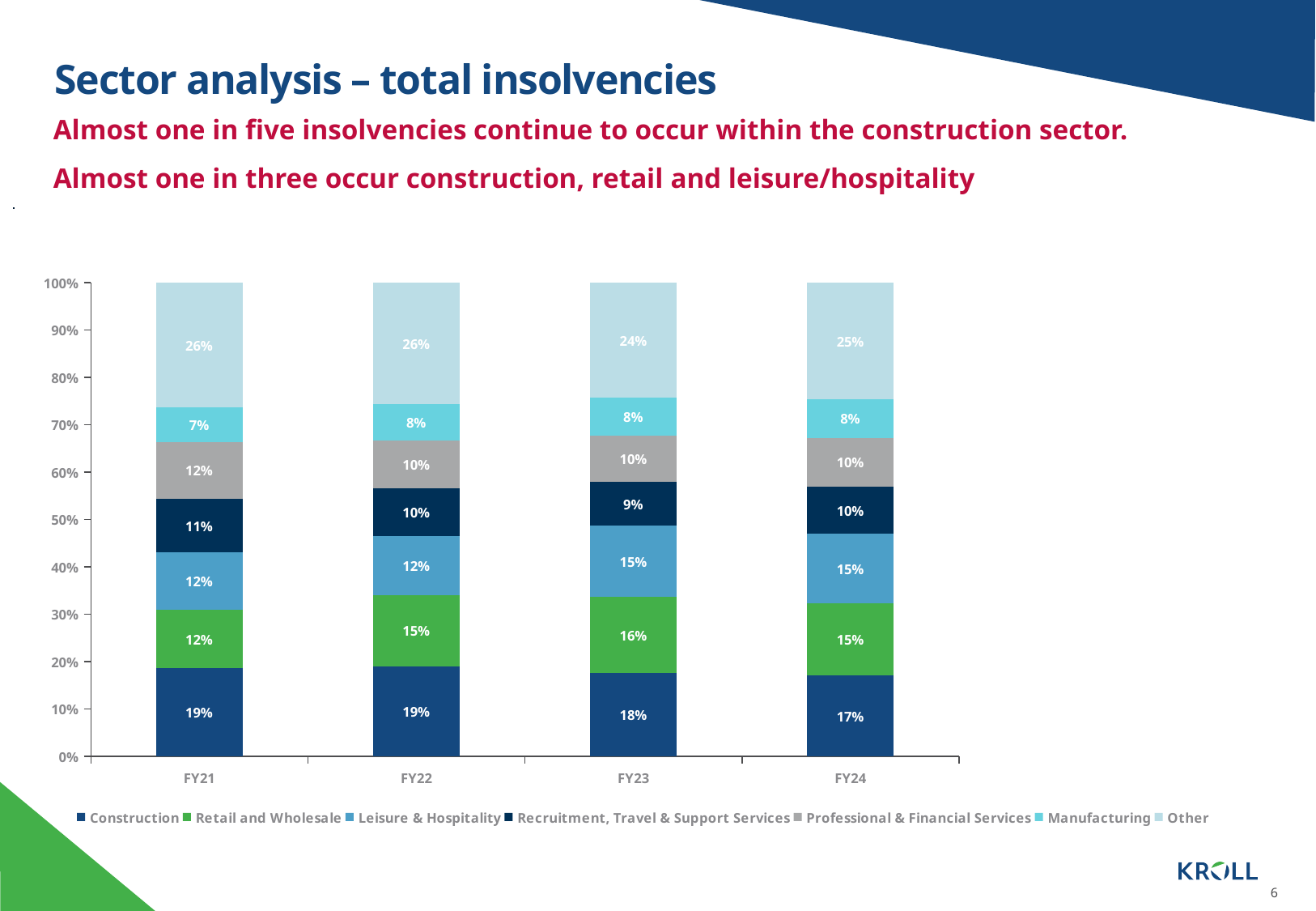
How many series does the legend list? 7 What is the Other share in FY24? 25% What kind of chart is shown on the slide? Stacked bar chart Which is larger in FY23: the Leisure & Hospitality share or the Recruitment, Travel & Support Services share? Leisure & Hospitality What is the Construction share in FY21? 19% What is the Retail and Wholesale share in FY23? 16% Does the Construction share rise or fall from FY21 to FY24? Fall What is the difference between the Construction share in FY21 and in FY24? 2% What is the Manufacturing share in FY21? 7% Which sector has the smallest share in FY21? Manufacturing How many fiscal years are shown on the x axis? 4 In which fiscal year is the Construction share lowest? FY24